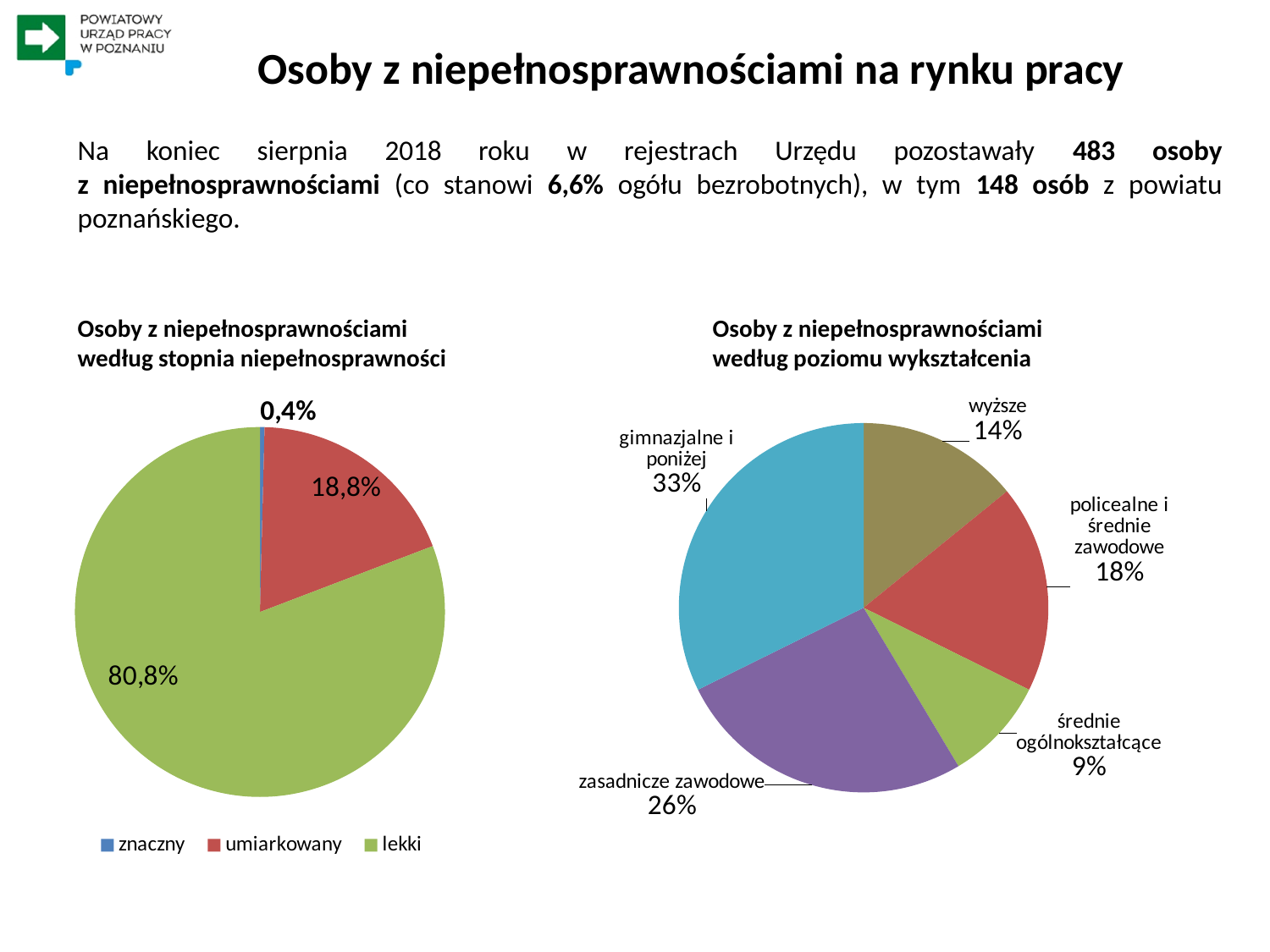
In the chart 'Osoby z niepełnosprawnościami według poziomu wykształcenia', what share is 'zasadnicze zawodowe'? 26% In the chart 'Osoby z niepełnosprawnościami według stopnia niepełnosprawności', what share is 'umiarkowany'? 18,8% In the chart 'Osoby z niepełnosprawnościami według poziomu wykształcenia', which category has the smallest share? średnie ogólnokształcące In the chart 'Osoby z niepełnosprawnościami według poziomu wykształcenia', how many categories are shown? 5 In the chart 'Osoby z niepełnosprawnościami według stopnia niepełnosprawności', which category has the smallest share? znaczny In the chart 'Osoby z niepełnosprawnościami według poziomu wykształcenia', what share is 'wyższe'? 14% In the chart 'Osoby z niepełnosprawnościami według poziomu wykształcenia', which is larger: 'policealne i średnie zawodowe' or 'wyższe'? policealne i średnie zawodowe In the chart 'Osoby z niepełnosprawnościami według stopnia niepełnosprawności', what share is 'lekki'? 80,8% In the chart 'Osoby z niepełnosprawnościami według poziomu wykształcenia', which category has the largest share? gimnazjalne i poniżej What kind of chart is 'Osoby z niepełnosprawnościami według poziomu wykształcenia'? Pie chart In the chart 'Osoby z niepełnosprawnościami według stopnia niepełnosprawności', how many entries does the legend list? 3 In the chart 'Osoby z niepełnosprawnościami według stopnia niepełnosprawności', what is the difference between the shares of 'lekki' and 'umiarkowany'? 62 percentage points